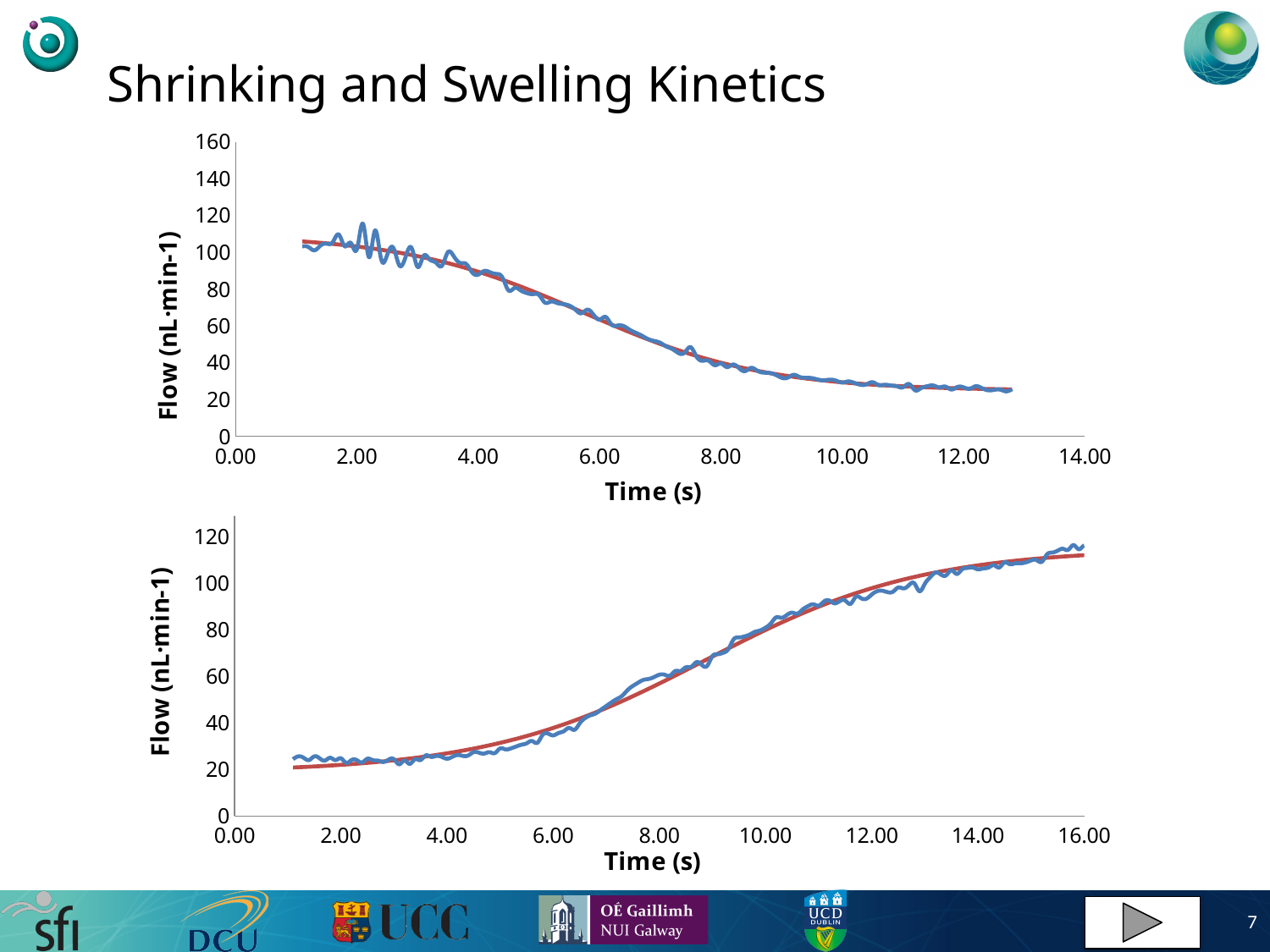
In the bottom chart, is the flow value at 2.00 s greater or less than 40? less In the top chart, is the flow value at 12.00 s greater or less than 40? less In the bottom chart, is the flow value at 8.00 s greater or less than 40? greater What kind of chart is the top chart on the slide? line chart What is the label of the y-axis on the top chart? Flow (nL·min-1) In the top chart, do the flow values rise or fall as time increases? fall What is the highest tick value on the x-axis of the bottom chart? 16.00 How many charts are shown on the slide? 2 In the bottom chart, do the flow values rise or fall as time increases? rise